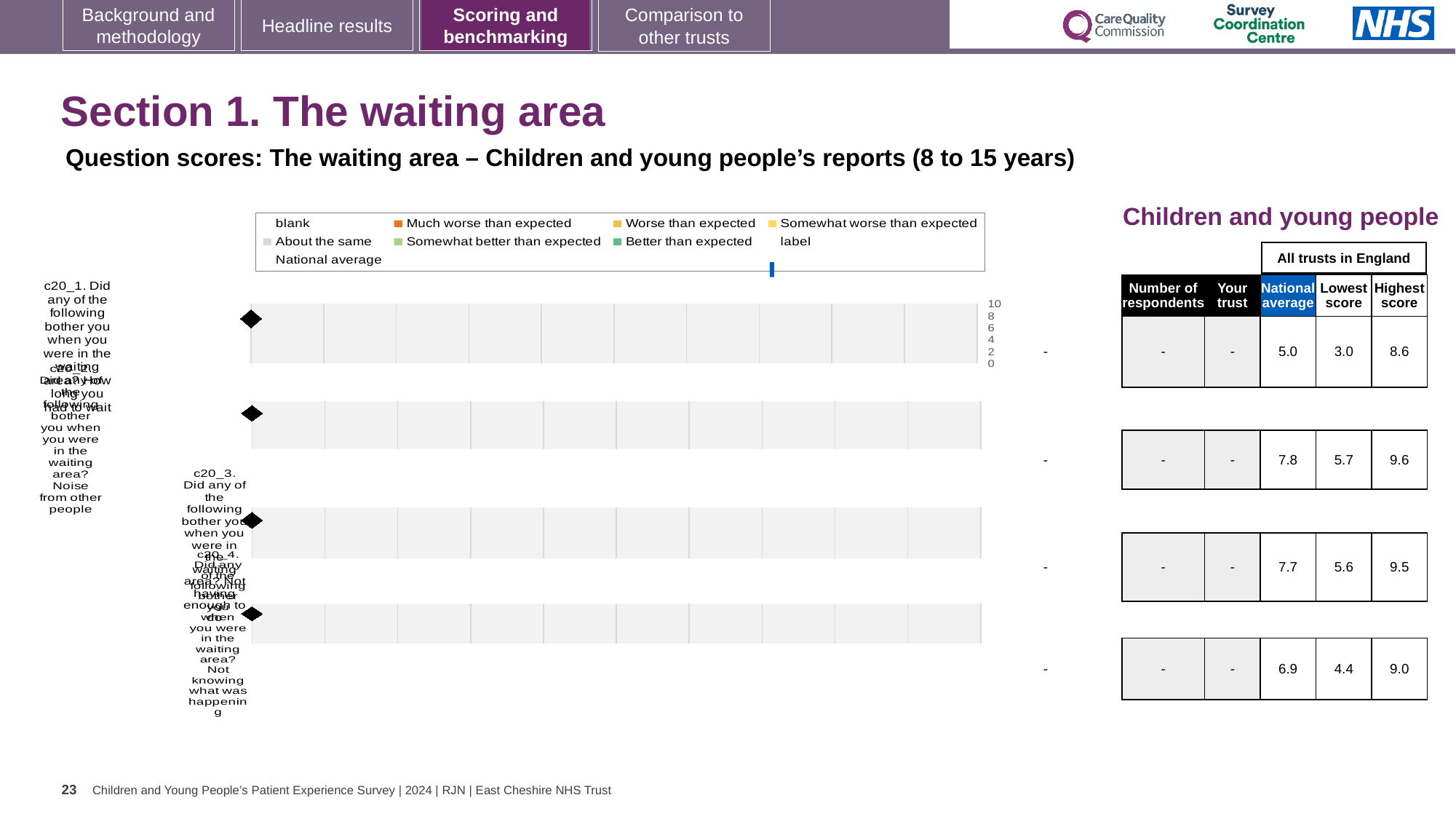
What is the highest value shown on the chart's axis? 10 In the table next to the chart, which question has the lowest national average? c20_1 (noise from other people) In the table next to the chart, what is the highest score for the second question (c20_2, how long you had to wait)? 9.6 In the table next to the chart, which question has the highest national average? c20_2 (how long you had to wait) What kind of chart is shown on the slide? bar chart In the table next to the chart, what is the national average for the fourth question (c20_4, not knowing what was happening)? 6.9 In the table next to the chart, what is the difference between the highest score and the lowest score for the fourth question (c20_4)? 4.6 How many question categories (rows) does the chart show? 4 In the table next to the chart, what is the lowest score for the third question (c20_3, not having enough to do)? 5.6 How many entries does the chart legend list? 9 In the table next to the chart, what is the national average for the first question (c20_1, noise from other people)? 5.0 Which legend entry is shown with an orange marker? Much worse than expected